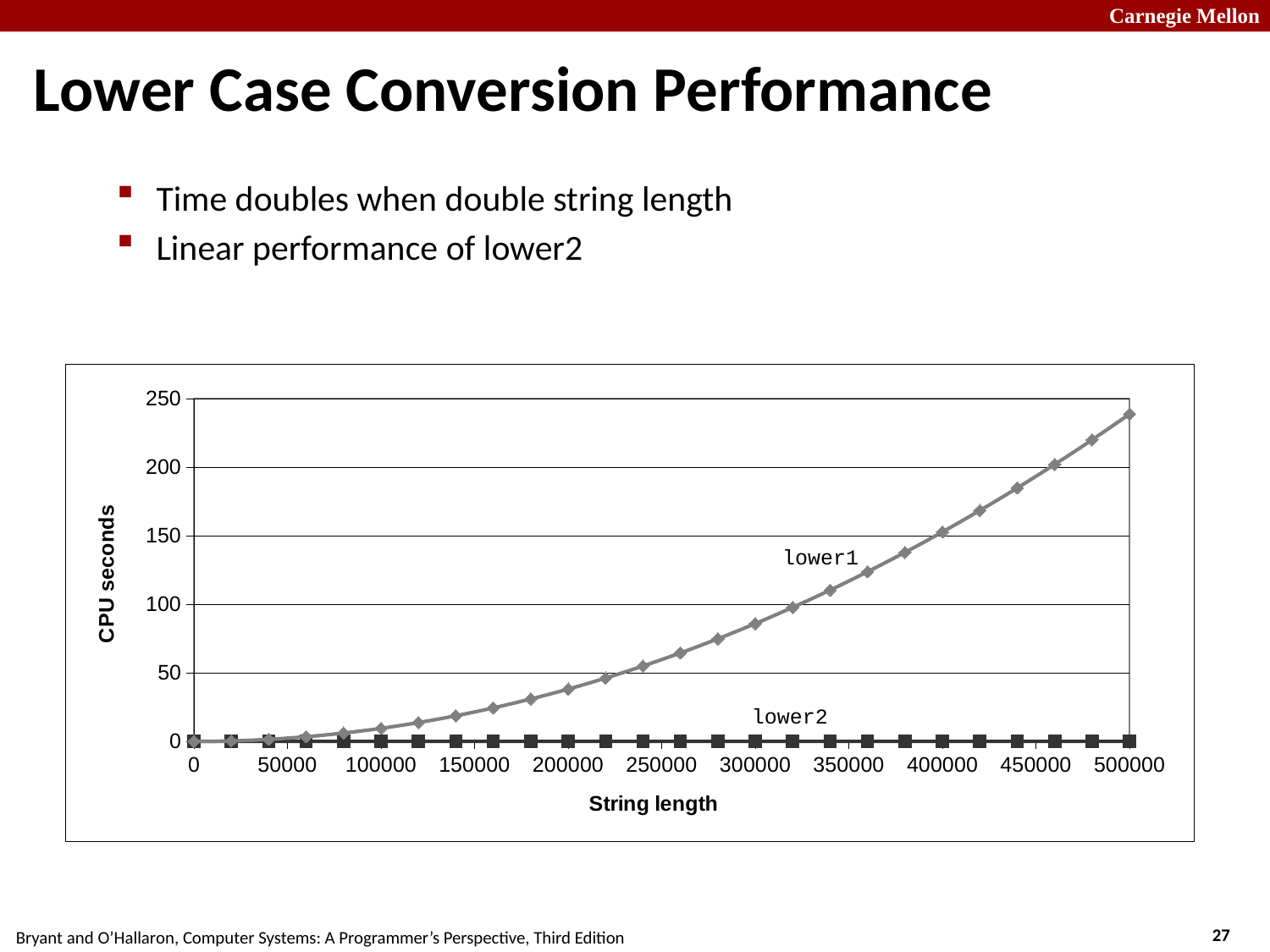
Is the CPU seconds value for lower1 at a string length of 300000 greater or less than 100? less Which series has the higher CPU seconds at a string length of 500000? lower1 What kind of chart is shown on the slide? line chart Is the CPU seconds value for lower1 at a string length of 500000 greater or less than 200? greater Which series reaches the highest CPU seconds on the chart? lower1 Is the CPU seconds value for lower1 at a string length of 400000 greater or less than 100? greater Which series stays lowest across all string lengths? lower2 What are the names of the two series plotted on the chart? lower1 and lower2 What is the label of the y axis? CPU seconds Does the CPU time for lower1 rise or fall as string length increases? rise How many series are plotted on the chart? 2